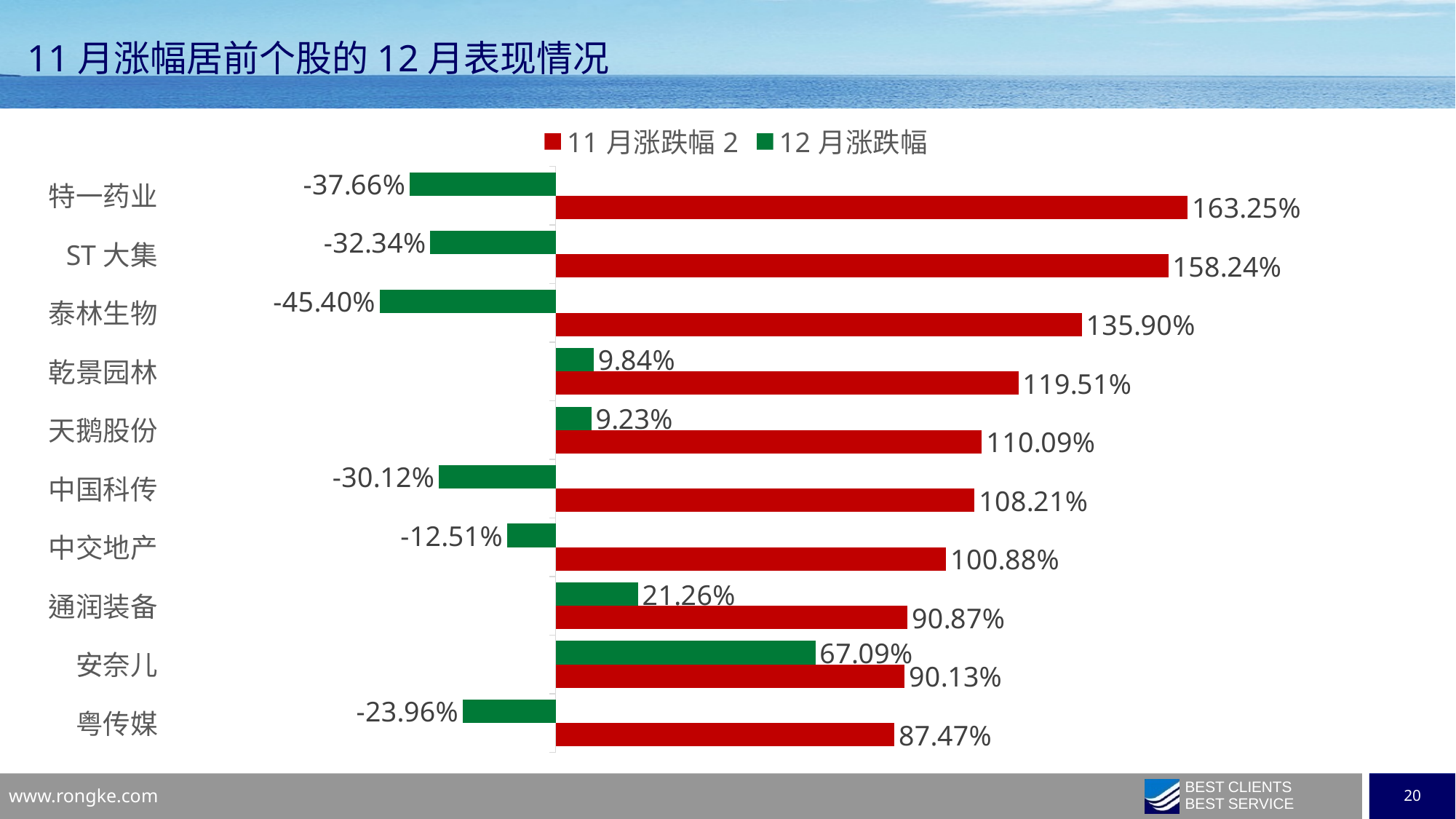
What is the 11 月涨跌幅 2 value for 粤传媒? 87.47% Which is larger, the 12 月涨跌幅 value for 通润装备 or for 乾景园林? 通润装备 What is the 12 月涨跌幅 value for 安奈儿? 67.09% How many series does the legend list? 2 Which stock has the lowest 12 月涨跌幅 value? 泰林生物 What is the 11 月涨跌幅 2 value for 特一药业? 163.25% Which stock has the highest 11 月涨跌幅 2 value? 特一药业 What is the difference between the 11 月涨跌幅 2 values of 特一药业 and ST 大集? 5.01% Which stock has the highest 12 月涨跌幅 value? 安奈儿 What is the 12 月涨跌幅 value for 泰林生物? -45.40% How many stocks are shown on the chart? 10 What kind of chart is shown on the slide? Bar chart